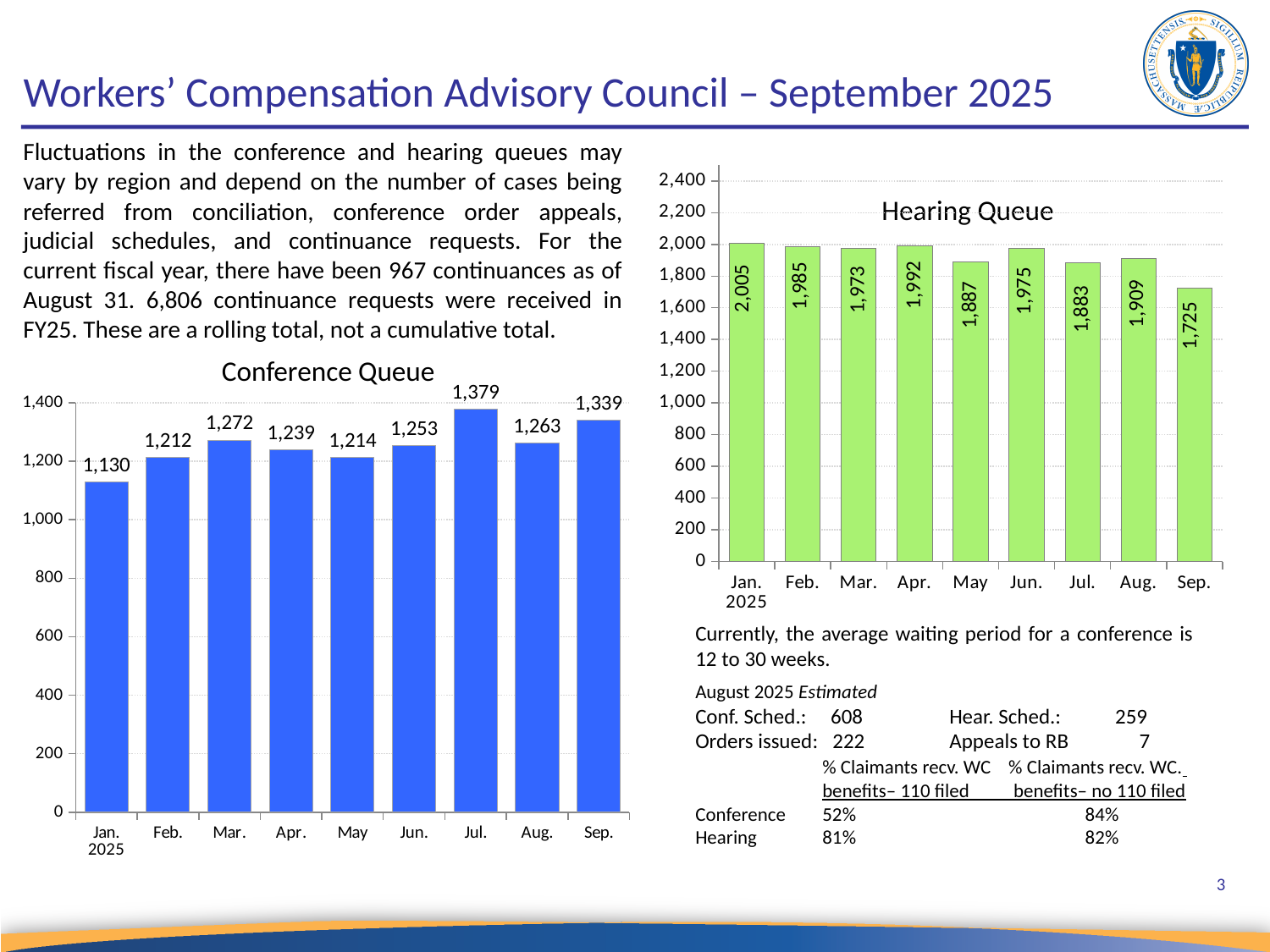
In the Hearing Queue chart, what is the difference between the Aug. value and the Sep. value? 184 In the Hearing Queue chart, which month has the highest value? Jan. 2025 In the Conference Queue chart, what is the difference between the Jul. value and the Jan. 2025 value? 249 How many months are plotted in the Conference Queue chart? 9 What colour are the bars in the Conference Queue chart? blue What kind of chart is the Hearing Queue chart? bar chart In the Conference Queue chart, which month has the lowest value? Jan. 2025 In the Hearing Queue chart, which month has the lowest value? Sep. In the Conference Queue chart, what is the value for Jul.? 1,379 In the Hearing Queue chart, what is the value for May? 1,887 In the Conference Queue chart, which is larger, the value for Mar. or the value for Apr.? Mar. In the Hearing Queue chart, is the value for Sep. greater or less than 1,800? less